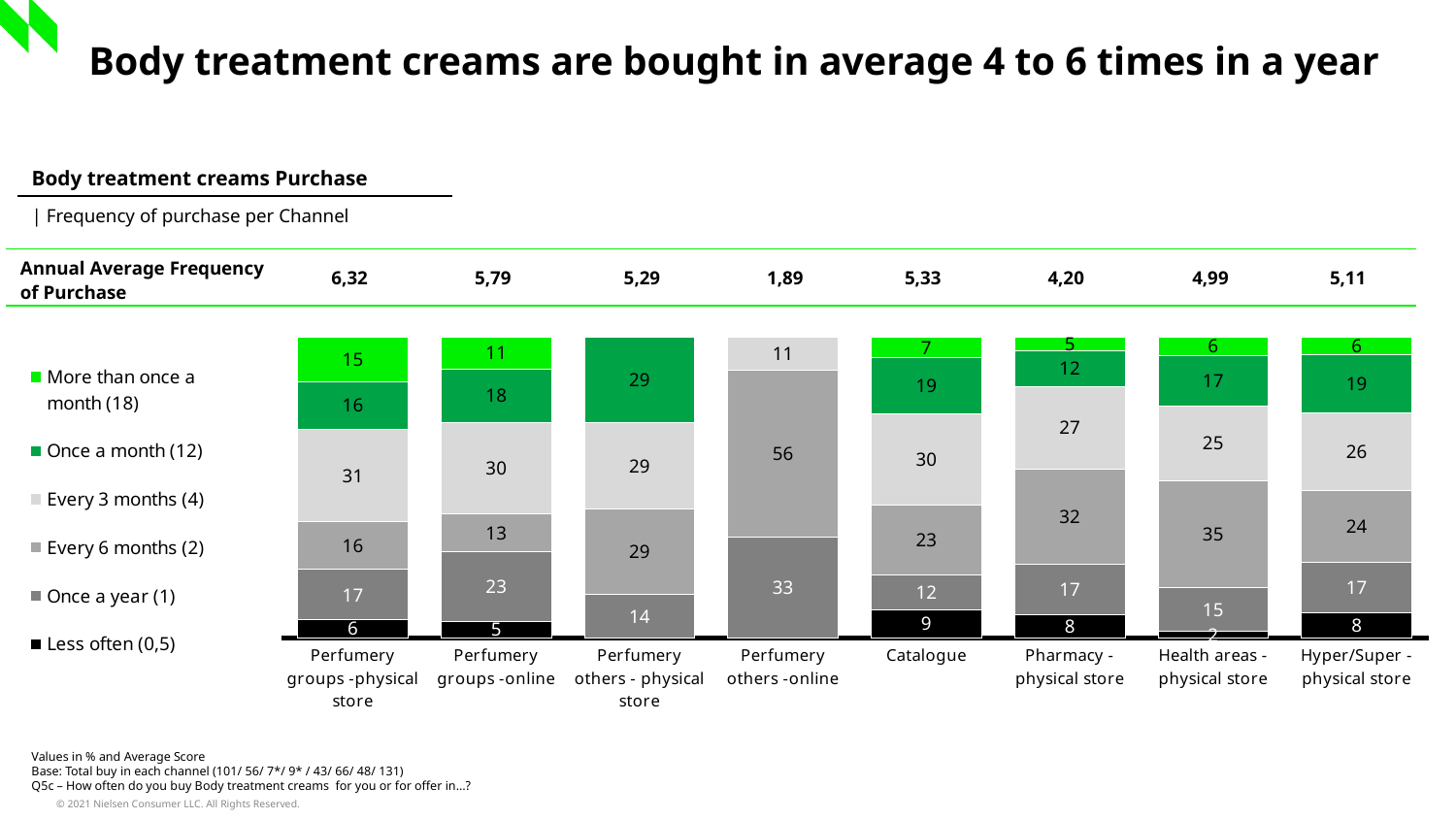
What is the difference between the 'Every 3 months (4)' values for Perfumery groups - physical store and Hyper/Super - physical store? 5 What is the 'More than once a month (18)' value for Perfumery groups - physical store? 15 Which channel has the highest Annual Average Frequency of Purchase? Perfumery groups - physical store What kind of chart is shown on the slide? Stacked bar chart What is the 'Once a year (1)' value for Perfumery groups - online? 23 Which channel has the highest 'Every 6 months (2)' value? Perfumery others - online What is the 'Less often (0,5)' value for Catalogue? 9 What is the 'Every 6 months (2)' value for Perfumery others - online? 56 What is the Annual Average Frequency of Purchase shown for Perfumery others - online? 1,89 Which has the larger 'Once a month (12)' value, Catalogue or Pharmacy - physical store? Catalogue How many series does the chart legend list? 6 How many purchase channels are shown along the x axis of the chart? 8